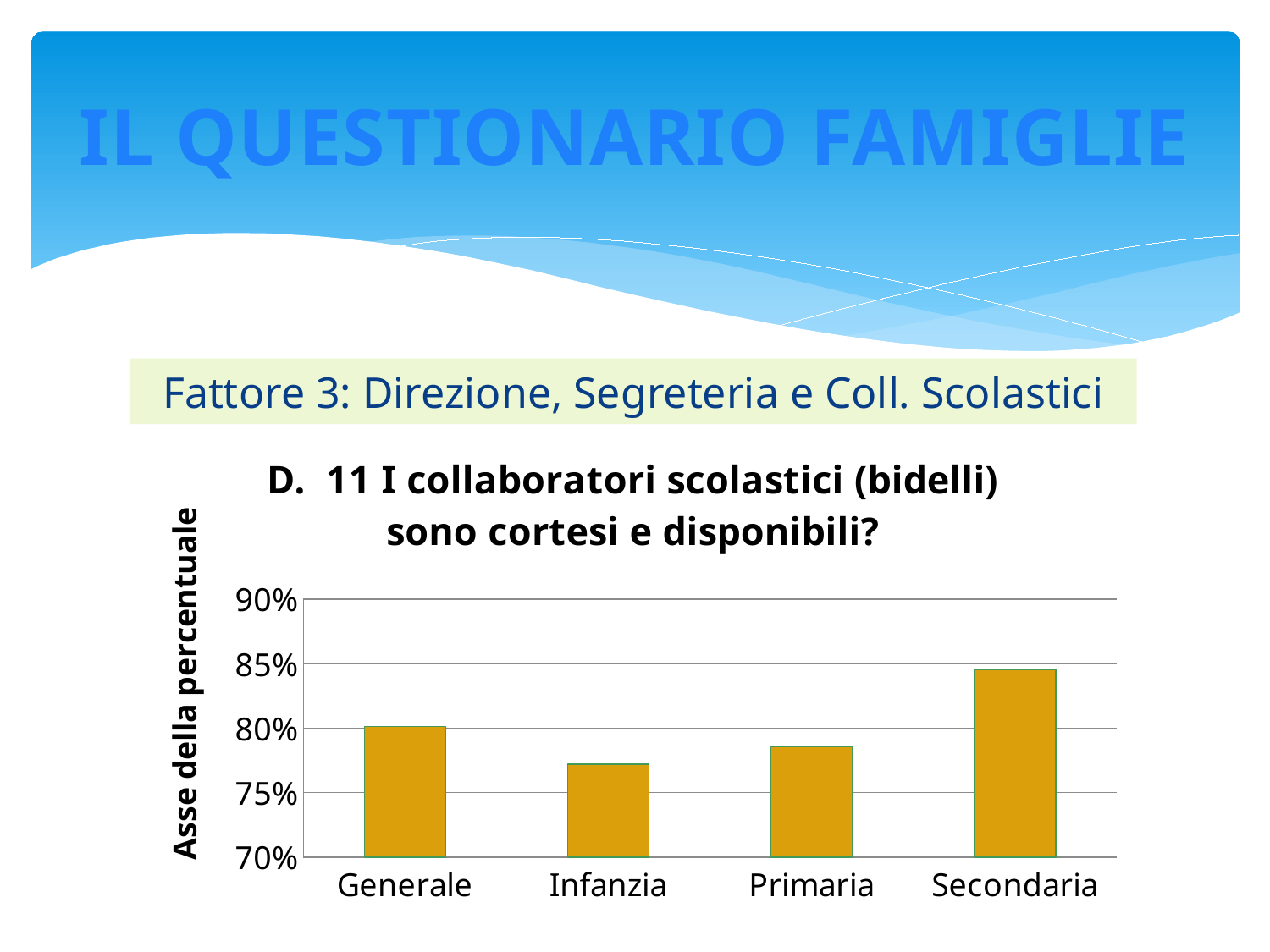
What kind of chart is shown on the slide? bar chart Is the value for Secondaria greater or less than 80%? greater What is the title of the y axis of the chart? Asse della percentuale Is the value for Primaria greater or less than 80%? less Is the value for Infanzia greater or less than 80%? less What is the title of the chart? D. 11 I collaboratori scolastici (bidelli) sono cortesi e disponibili? Which is larger, the value for Secondaria or the value for Primaria? Secondaria Which category has the lowest value in the chart? Infanzia How many categories are shown on the x axis of the chart? 4 Which category has the highest value in the chart? Secondaria Which is larger, the value for Generale or the value for Infanzia? Generale